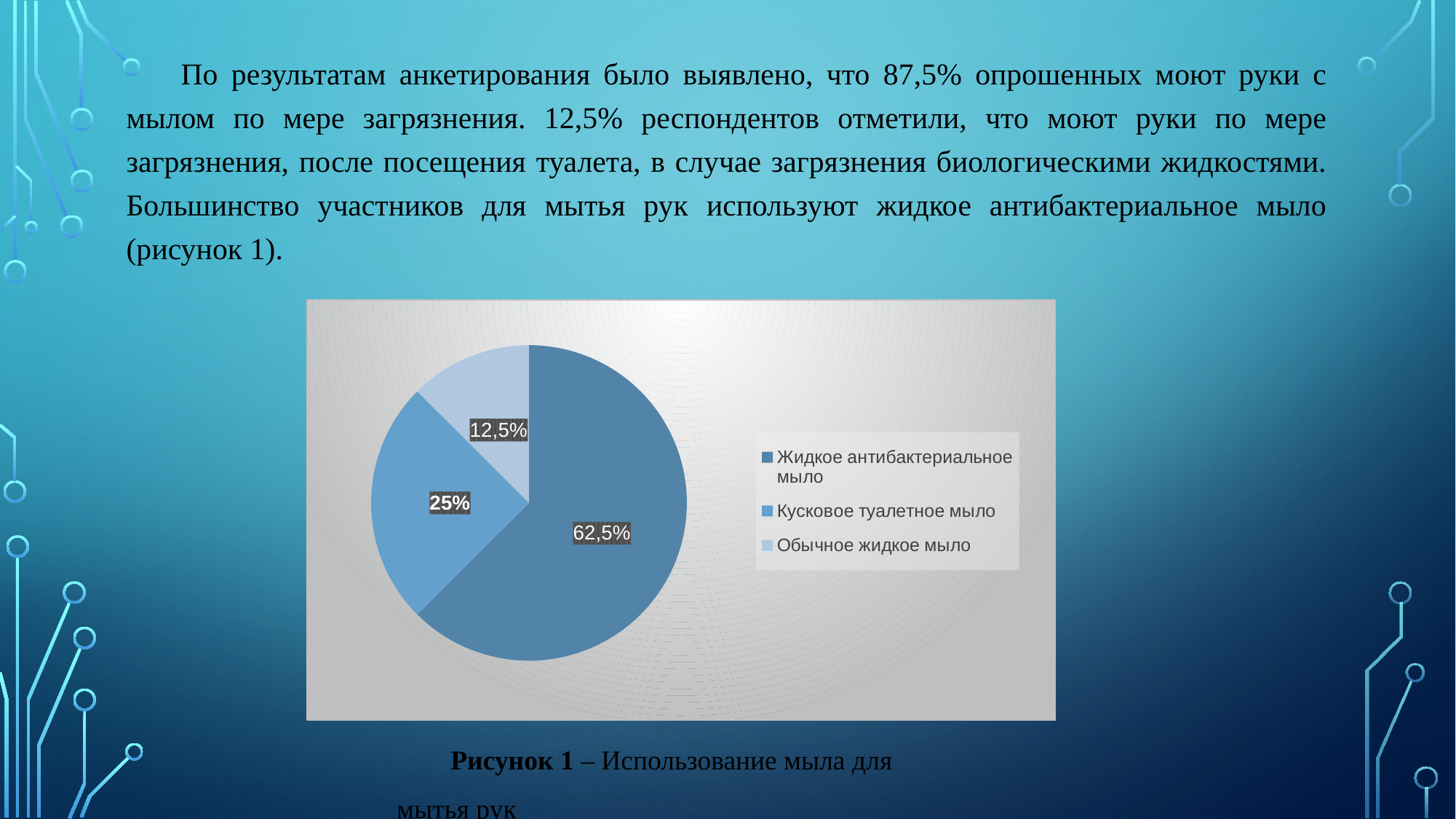
What share of the pie does "Кусковое туалетное мыло" take? 25% What share of the pie does "Жидкое антибактериальное мыло" take? 62,5% Which is larger: the slice for "Кусковое туалетное мыло" or the slice for "Обычное жидкое мыло"? Кусковое туалетное мыло What kind of chart is shown on the slide? Pie chart What is the difference in percentage points between "Кусковое туалетное мыло" and "Обычное жидкое мыло"? 12,5 What is the difference in percentage points between "Жидкое антибактериальное мыло" and "Кусковое туалетное мыло"? 37,5 How many entries does the legend list? 3 How many slices does the pie chart have? 3 Which category has the largest slice of the pie? Жидкое антибактериальное мыло What is the caption given below the chart? Рисунок 1 – Использование мыла для мытья рук What share of the pie does "Обычное жидкое мыло" take? 12,5% Which category has the smallest slice of the pie? Обычное жидкое мыло